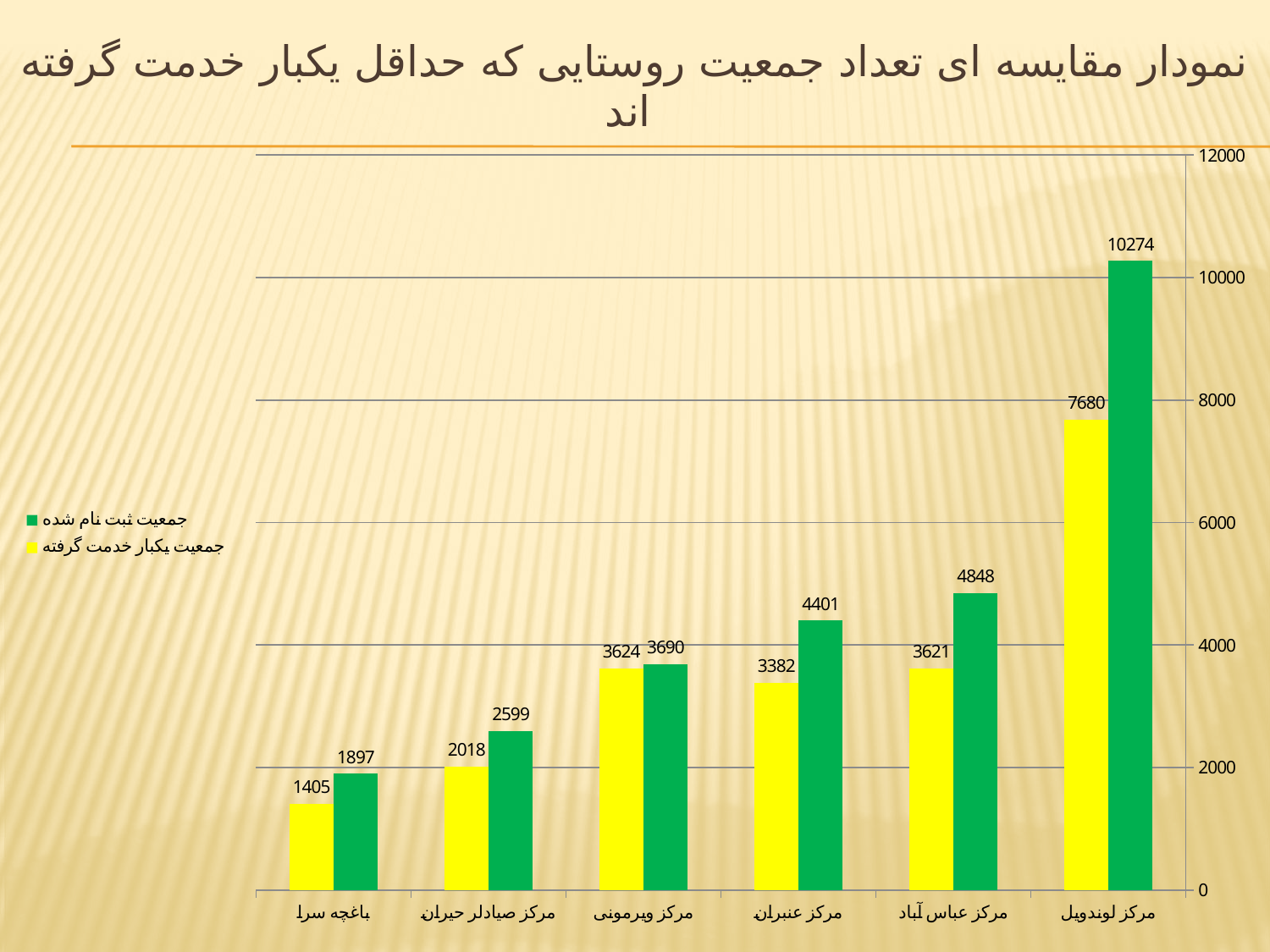
What is the value of جمعیت یکبار خدمت گرفته for مرکز عباس آباد? 3621 How many categories are shown on the x axis? 6 Which colour represents جمعیت یکبار خدمت گرفته in the legend? yellow What is the value of جمعیت ثبت نام شده for مرکز لوندویل? 10274 What type of chart is shown on the slide? bar chart Which category has the lowest value of جمعیت یکبار خدمت گرفته? باغچه سرا How many series does the legend list? 2 Which is larger for مرکز عباس آباد: جمعیت ثبت نام شده or جمعیت یکبار خدمت گرفته? جمعیت ثبت نام شده Which category has the highest value of جمعیت ثبت نام شده? مرکز لوندویل What is the value of جمعیت ثبت نام شده for مرکز عنبران? 4401 What is the difference between جمعیت ثبت نام شده and جمعیت یکبار خدمت گرفته for مرکز لوندویل? 2594 Is the value of جمعیت ثبت نام شده for مرکز صیادلر حیران greater or less than 2000? greater